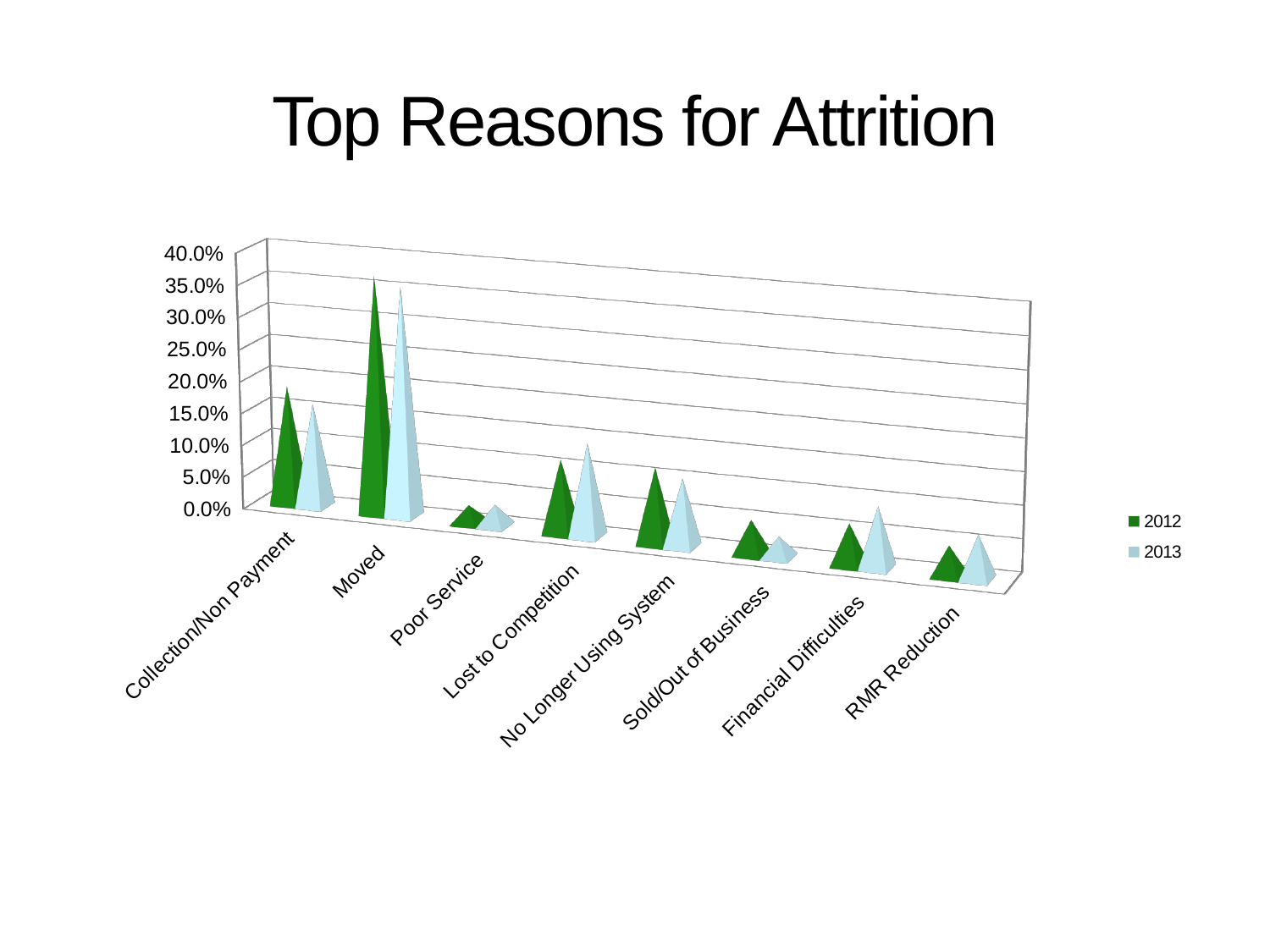
Which reason has the highest value for 2012? Moved How many series does the legend list? 2 Is the 2013 value for Lost to Competition greater or less than 20.0%? less Is the 2012 value for Moved greater or less than 20.0%? greater How many attrition reasons (categories) are shown on the x axis? 8 Which series is shown in dark green in the legend? 2012 For Lost to Competition, which year has the larger value, 2012 or 2013? 2013 What is the title of the chart? Top Reasons for Attrition For Sold/Out of Business, which year has the larger value, 2012 or 2013? 2012 What kind of chart is shown on the slide? bar chart Is the 2012 value for Poor Service greater or less than 5.0%? less